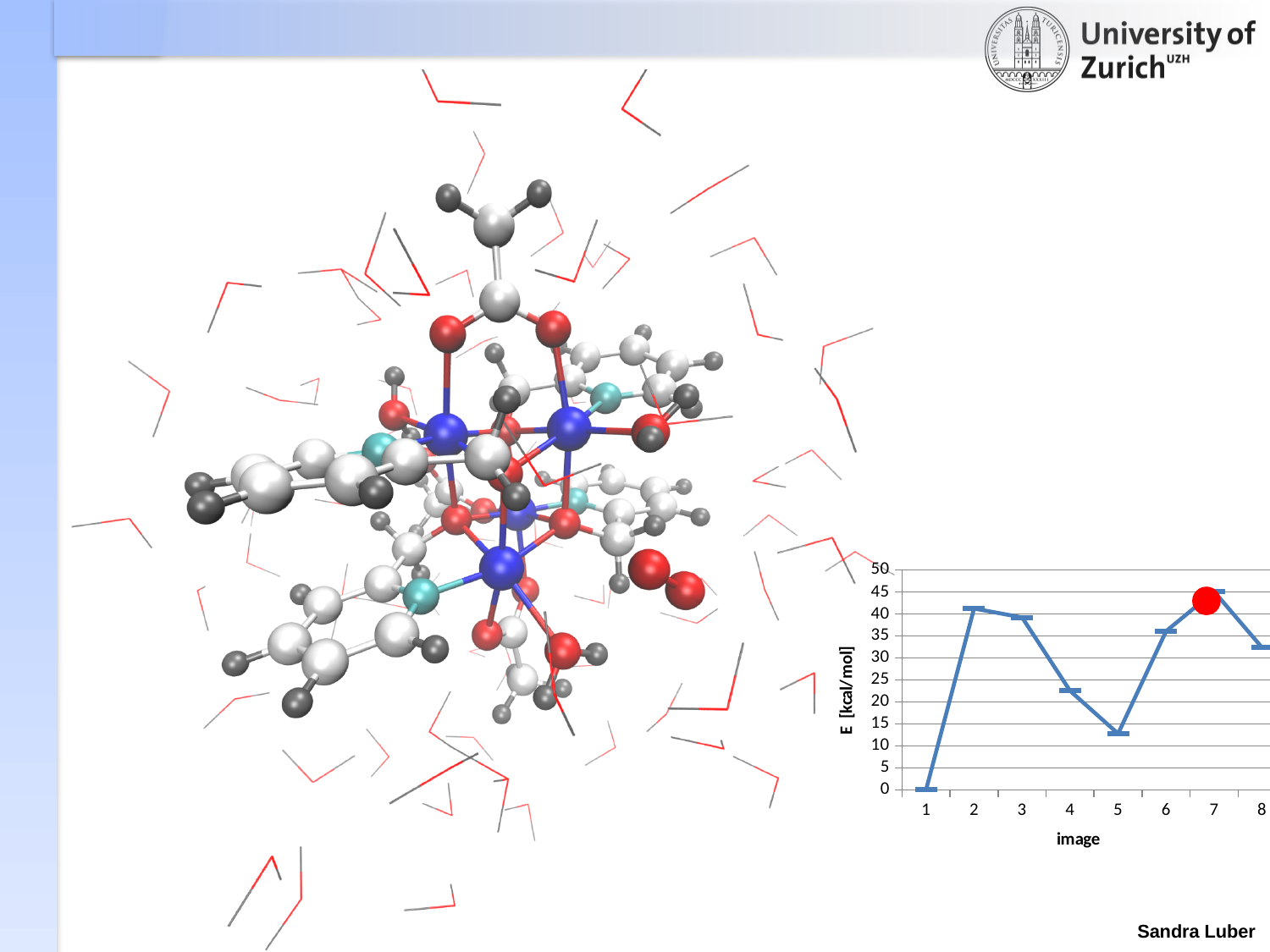
Is the energy value for image 4 greater or less than 25? less What kind of chart is shown on the slide? line chart Which has the higher energy, image 6 or image 8? image 6 How many images (x-axis points) are plotted on the chart? 8 What is the label of the x axis of the chart? image Which image has the lowest energy on the chart? 1 Does the energy rise or fall from image 3 to image 5? fall Is the energy value for image 2 greater or less than 40? greater What is the label of the y axis of the chart? E [kcal/mol] Is the energy value for image 5 greater or less than 15? less Which image has the highest energy on the chart? 7 What is the energy value for image 1? 0